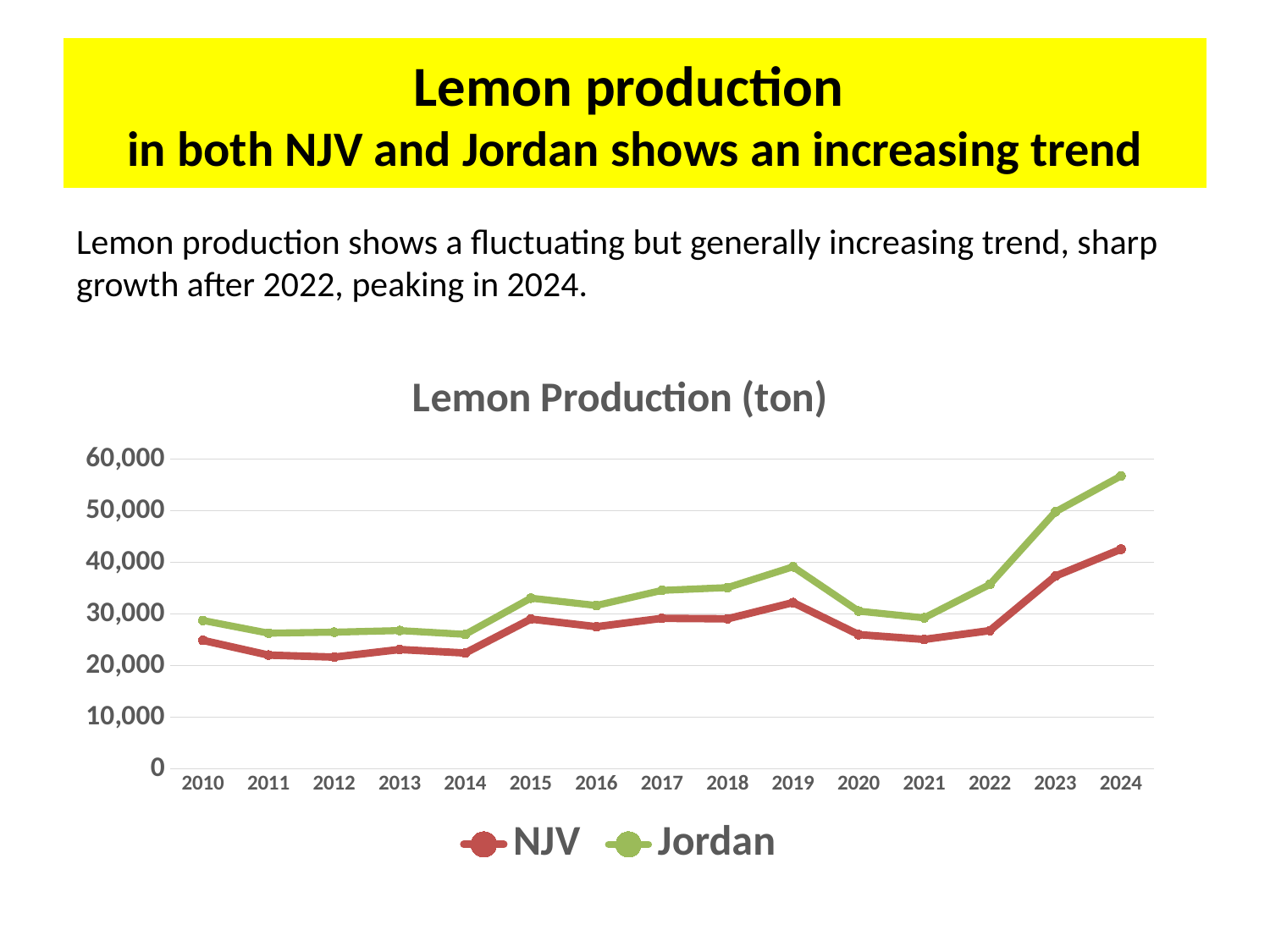
How many years are plotted along the x axis? 15 How many series does the legend list? 2 Is the value for Jordan in 2024 greater or less than 50,000? greater Is the value for NJV in 2024 greater or less than 40,000? greater What kind of chart is shown on the slide? line chart In 2024, which series has the larger value, NJV or Jordan? Jordan In which year does the NJV series reach its highest value? 2024 In which year does the Jordan series reach its highest value? 2024 Overall, do the values for Jordan rise or fall from 2010 to 2024? rise Is the value for NJV in 2023 greater or less than 40,000? less What is the title of the chart? Lemon Production (ton)